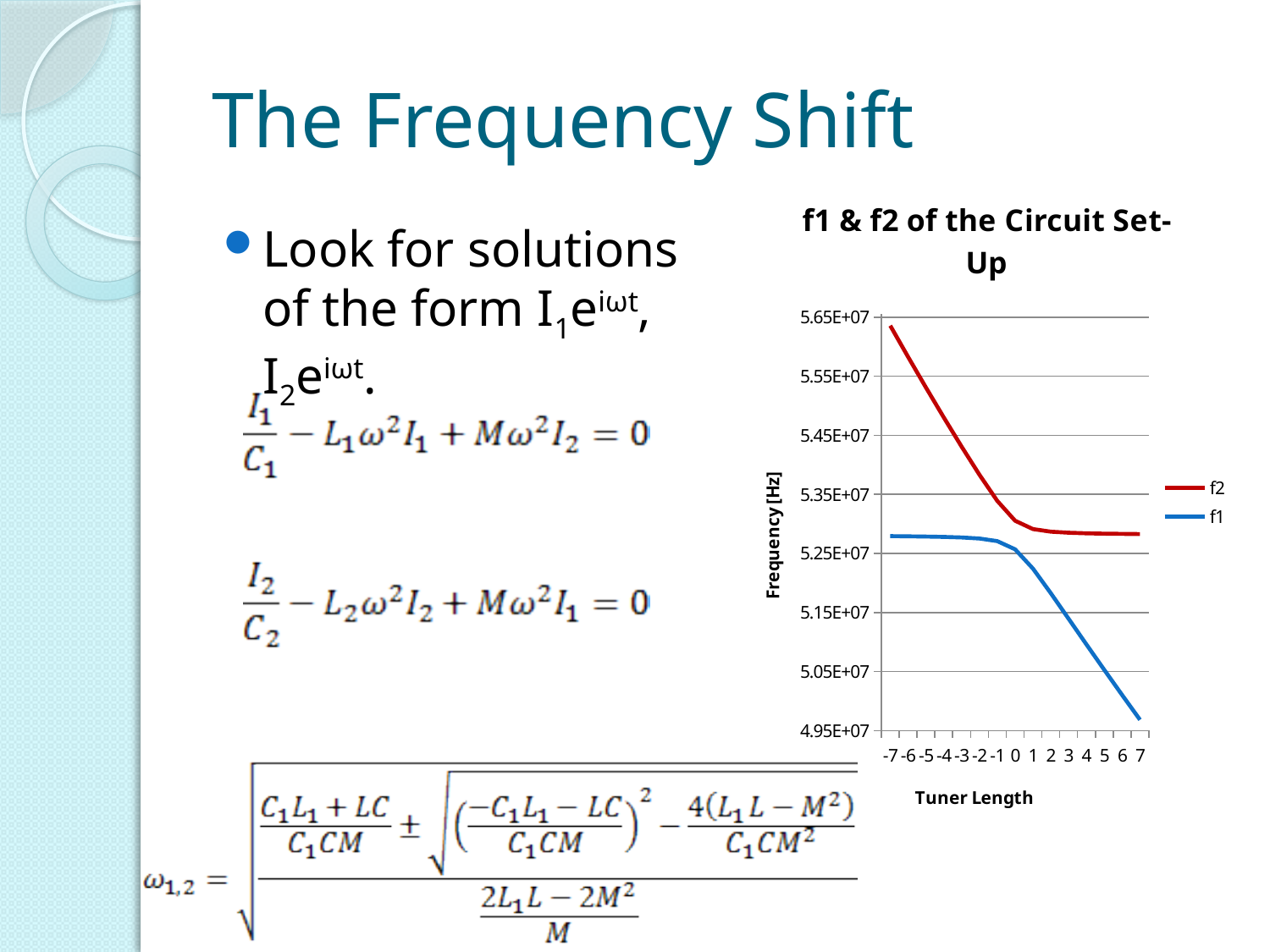
What is the title of the chart? f1 & f2 of the Circuit Set-Up What are the names of the two series in the chart's legend? f2 and f1 How many tuner length values are marked along the x axis of the chart? 15 Is the value of f1 at tuner length 4 greater or less than 5.15E+07? less Is the value of f2 at tuner length 2 greater or less than 5.35E+07? less Does the f1 series rise or fall as tuner length increases from -7 to 7? fall How many series does the legend of the chart list? 2 Does the f2 series rise or fall as tuner length increases from -7 to 7? fall What kind of chart is shown on the slide? line chart Is the value of f1 at tuner length 7 greater or less than 5.05E+07? less At tuner length -7, which series has the higher frequency, f1 or f2? f2